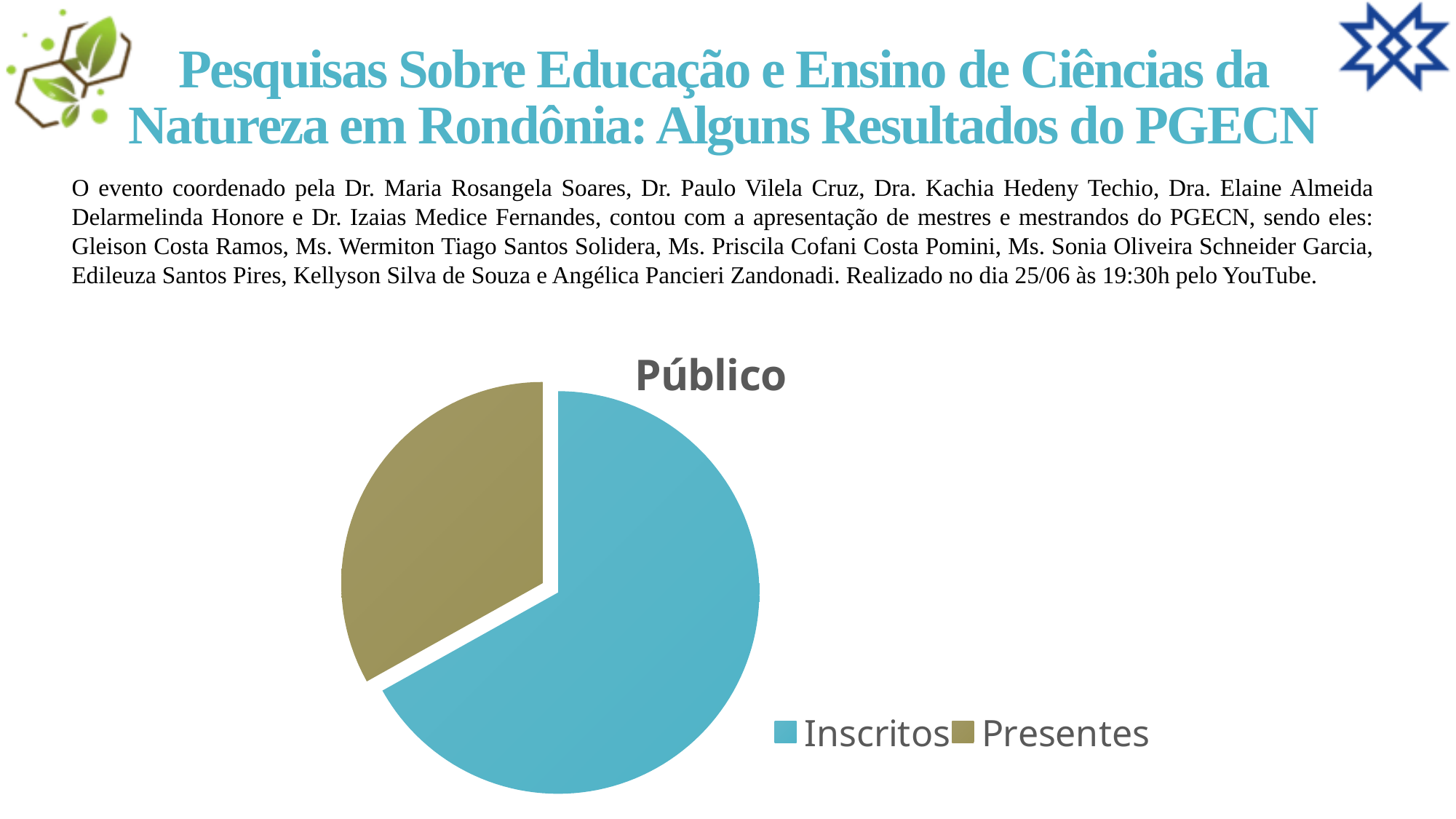
What is the title of the chart? Público What kind of chart is shown on the slide? pie chart Which category has the smallest slice of the pie? Presentes Which colour represents Presentes in the pie chart? olive/khaki How many slices does the pie chart have? 2 How many entries does the chart legend list? 2 Which is larger, the slice for Inscritos or the slice for Presentes? Inscritos Does the Presentes slice take up more or less than half of the pie? less Which category has the largest slice of the pie? Inscritos Does the Inscritos slice take up more or less than half of the pie? more